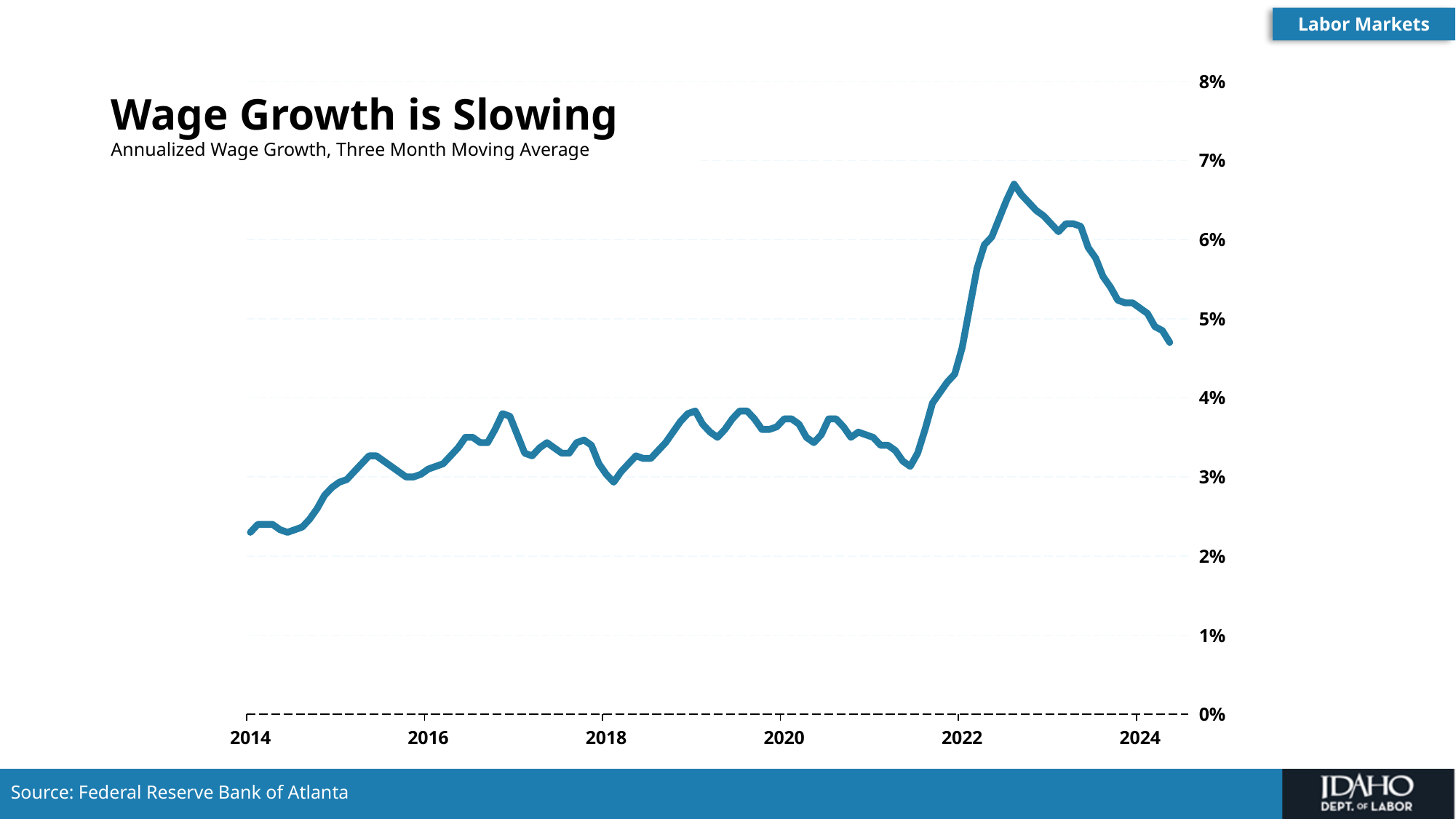
Does the line rise or fall from its peak to the end of the series in 2024? fall What kind of chart is shown on the slide? line chart Is the value at the end of the line in 2024 higher or lower than the value at the start in 2014? higher What is the title of the chart? Wage Growth is Slowing Is the value at the start of the line in 2014 greater or less than 2%? greater How many lines are plotted on the chart? 1 Is the value at the end of the line in 2024 greater or less than 4%? greater What is the subtitle of the chart? Annualized Wage Growth, Three Month Moving Average Is the value at the 2020 tick greater or less than 3%? greater